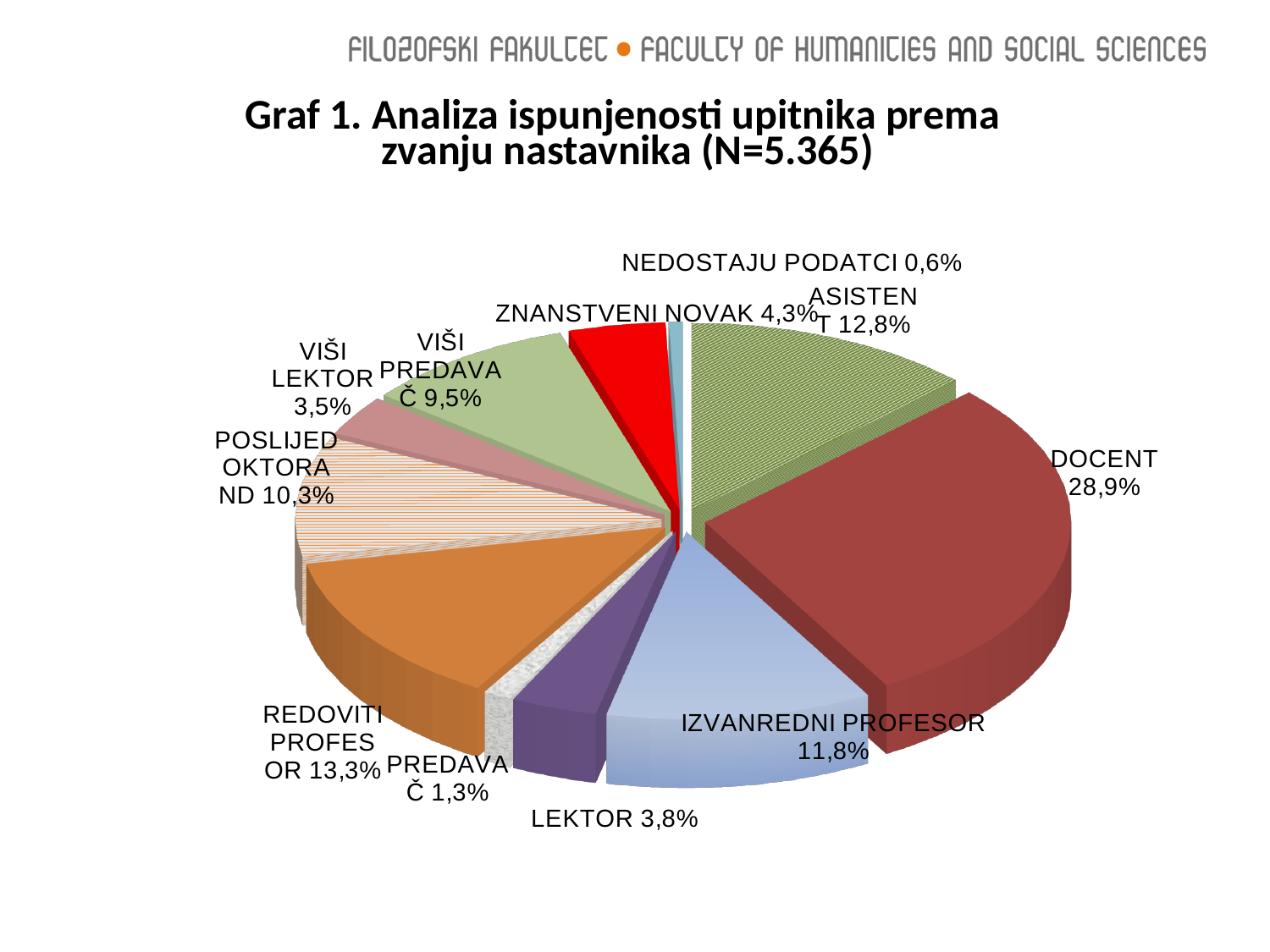
What type of chart is shown on the slide? Pie chart What is the N value given in the chart title? 5.365 Which category has the largest slice of the pie? DOCENT Which is larger, the share for VIŠI PREDAVAČ or the share for ZNANSTVENI NOVAK? VIŠI PREDAVAČ How many categories (slices) are shown in the pie chart? 11 What is the difference in percentage points between REDOVITI PROFESOR and IZVANREDNI PROFESOR? 1,5 What share of the pie does ASISTENT have? 12,8% What is the value shown for POSLIJEDOKTORAND? 10,3% What is the value shown for IZVANREDNI PROFESOR? 11,8% What share of the pie does DOCENT have? 28,9% Which category has the smallest slice of the pie? NEDOSTAJU PODATCI Which is larger, the share for LEKTOR or the share for VIŠI LEKTOR? LEKTOR